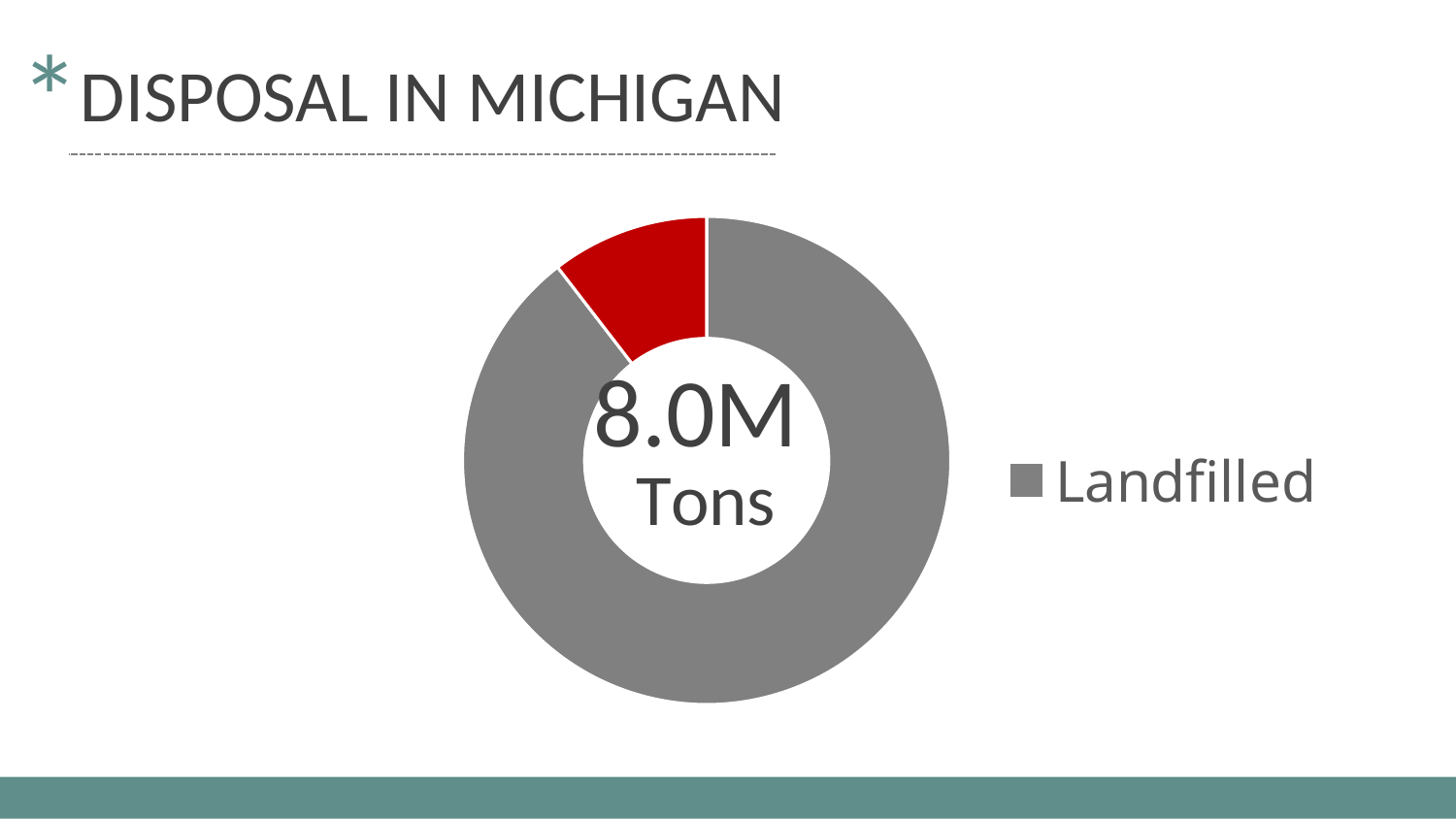
Which colour slice takes up the largest share of the doughnut chart? gray Which colour slice takes up the smallest share of the doughnut chart? red Does the Landfilled slice account for more or less than half of the doughnut chart? more What is the only entry shown in the chart's legend? Landfilled What kind of chart is shown on the slide? Doughnut (pie) chart What text is printed in the centre of the doughnut chart? 8.0M Tons Is the Landfilled slice larger or smaller than the red slice? larger What is the title of the slide containing the chart? DISPOSAL IN MICHIGAN How many slices does the doughnut chart have? 2 How many entries does the chart's legend list? 1